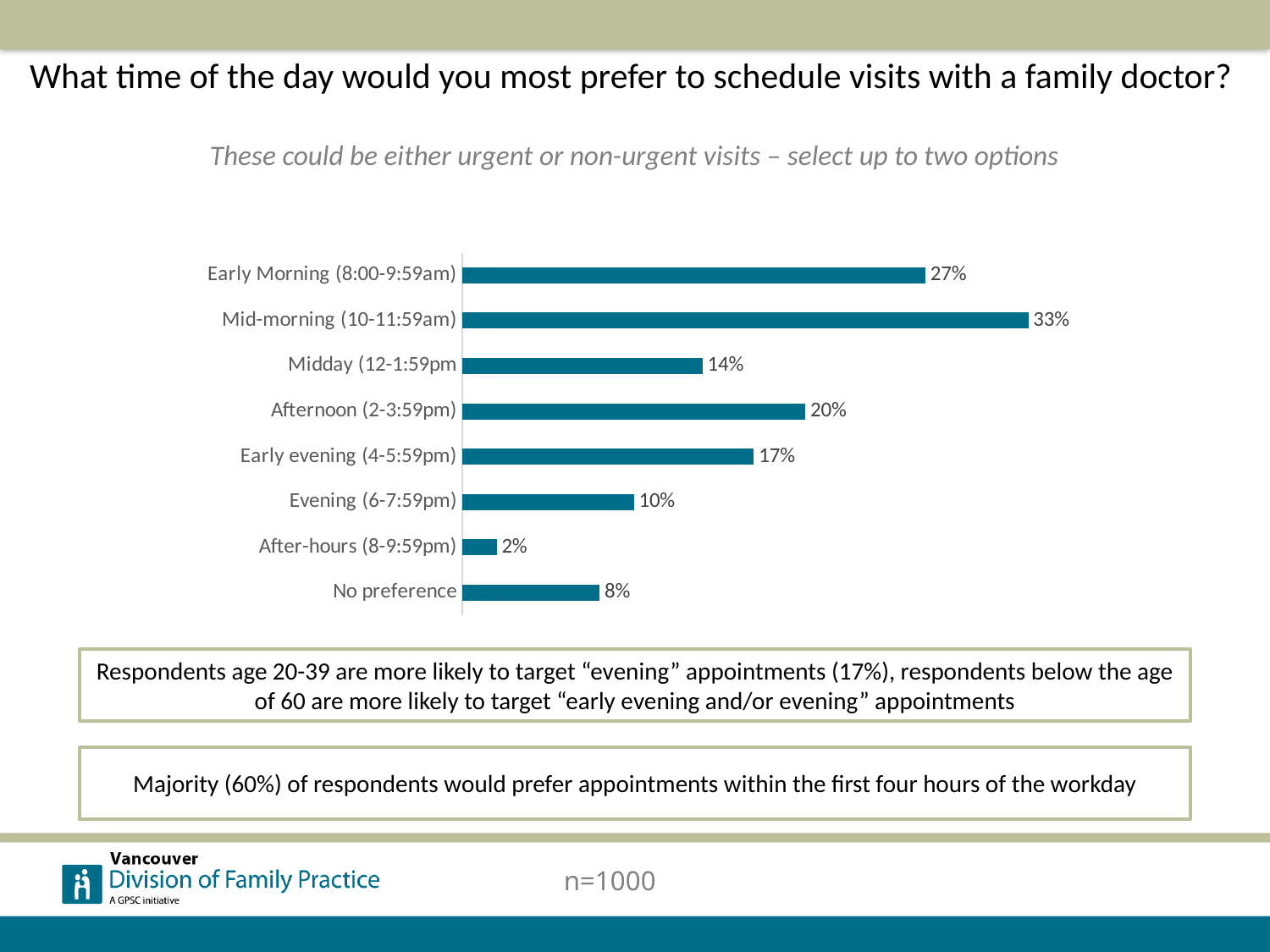
Which category has the lowest value on the chart? After-hours (8-9:59pm) What is the value shown for Early evening (4-5:59pm)? 17% What percentage of respondents selected No preference? 8% Which is larger, the value for Midday (12-1:59pm) or the value for Afternoon (2-3:59pm)? Afternoon (2-3:59pm) What percentage of respondents prefer Mid-morning (10-11:59am) visits? 33% What is the difference between the Mid-morning (10-11:59am) and Early Morning (8:00-9:59am) values? 6% What colour are the bars in the chart? Teal blue What kind of chart is shown on the slide? Bar chart Which time slot has the highest percentage of respondents? Mid-morning (10-11:59am) What is the sample size shown on the slide? n=1000 How many categories are shown on the chart? 8 What is the difference between the Afternoon (2-3:59pm) and Evening (6-7:59pm) values? 10%